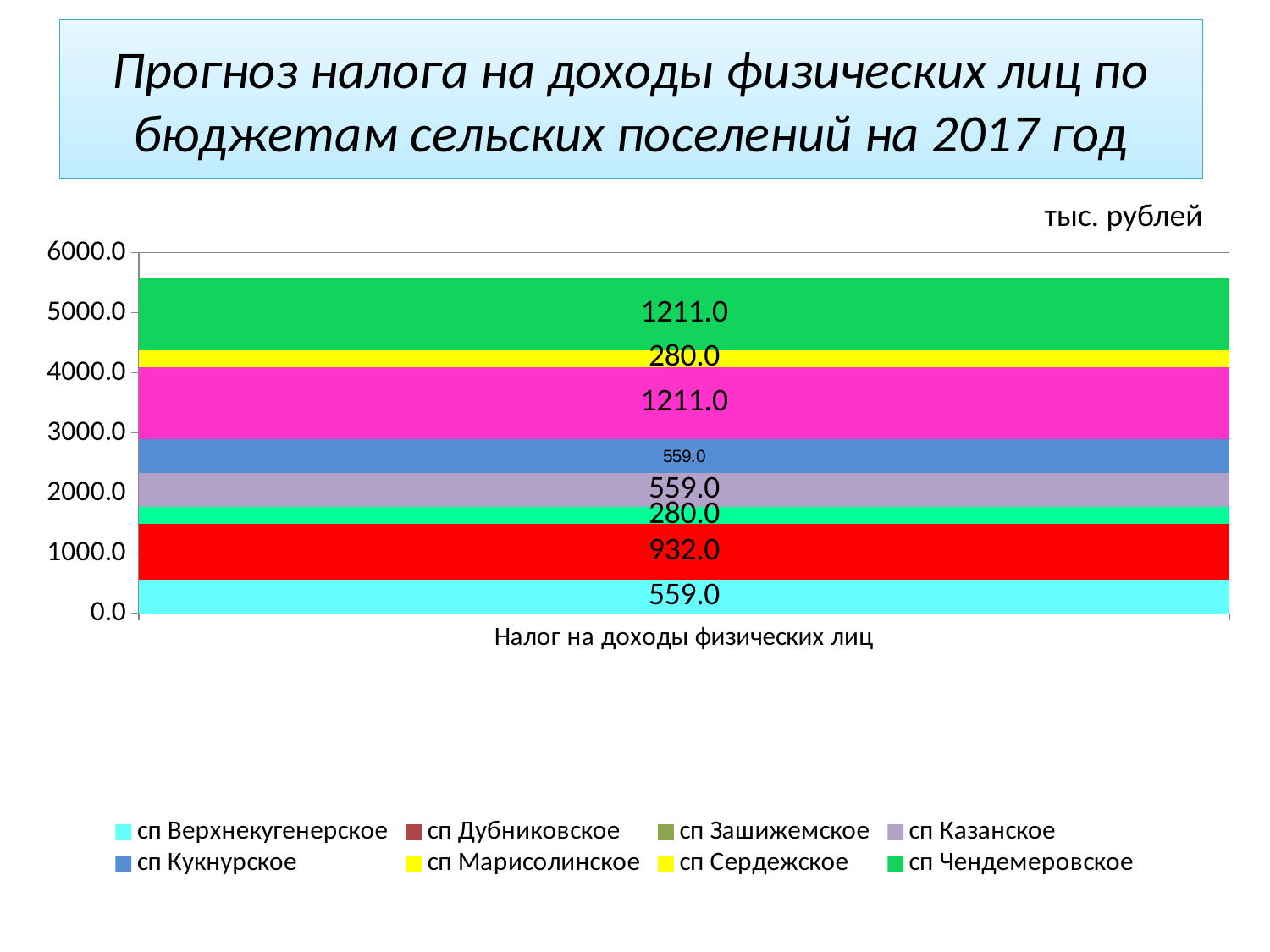
What kind of chart is shown on the slide? stacked bar chart What is the total of the stacked bar for Налог на доходы физических лиц? 5591.0 What is the value for сп Кукнурское? 559.0 What is the value for сп Дубниковское? 932.0 How many categories are plotted on the x axis? 1 Which is larger, the value for сп Дубниковское or сп Сердежское? сп Дубниковское What is the value for сп Верхнекугенерское? 559.0 What is the difference between the values for сп Чендемеровское and сп Верхнекугенерское? 652.0 What is the value for сп Сердежское? 280.0 What is the value for сп Чендемеровское? 1211.0 What unit is stated above the chart? тыс. рублей How many series does the legend list? 8